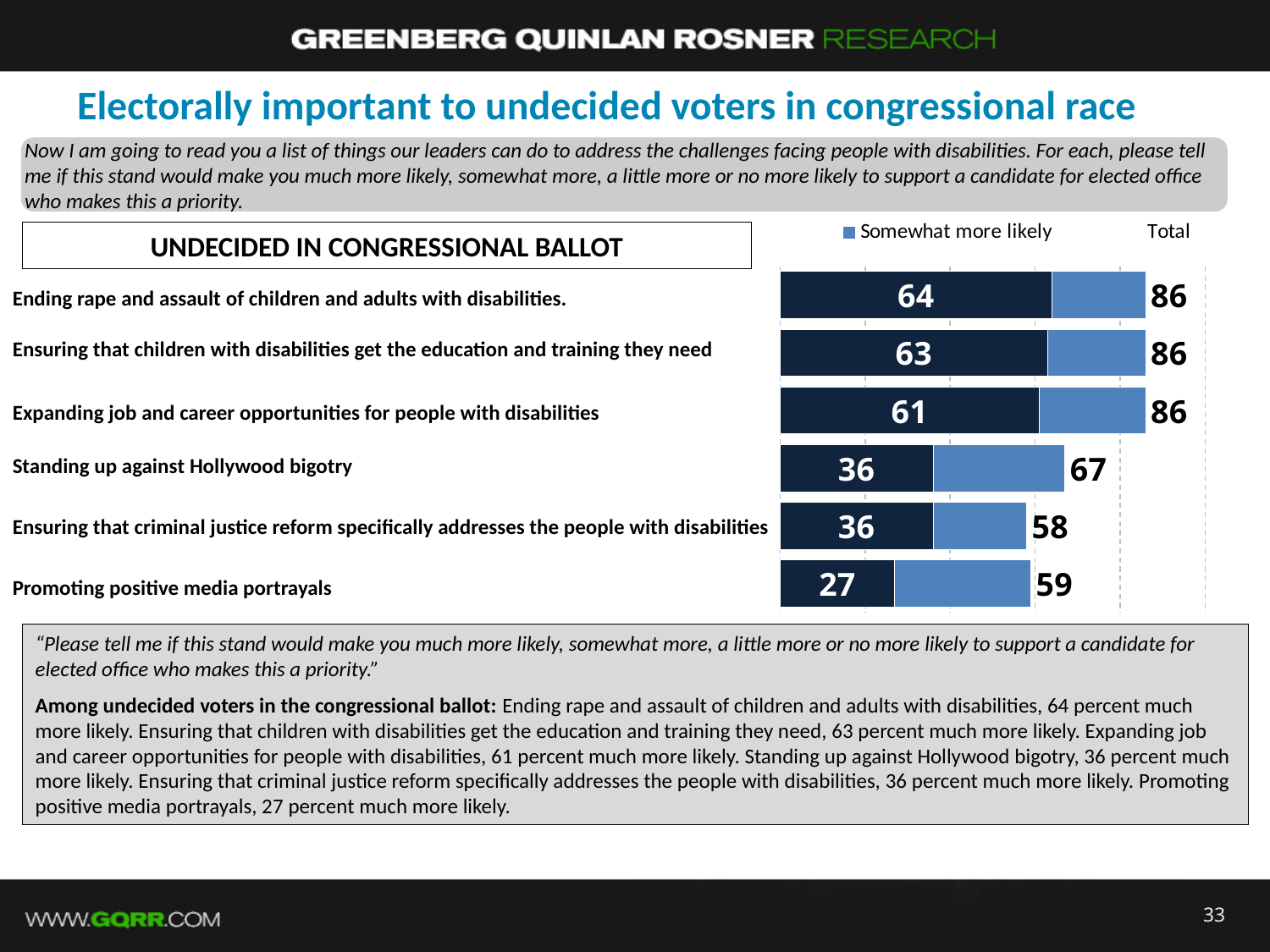
What is the value printed inside the dark bar segment for "Ending rape and assault of children and adults with disabilities"? 64 Which category has the highest value printed in its dark bar segment? Ending rape and assault of children and adults with disabilities What is the Total shown for "Standing up against Hollywood bigotry"? 67 Which category has the lowest value printed in its dark bar segment? Promoting positive media portrayals What is the difference between the dark-segment values for "Ending rape and assault of children and adults with disabilities" and "Promoting positive media portrayals"? 37 What is the value printed inside the dark bar segment for "Expanding job and career opportunities for people with disabilities"? 61 Based on the printed dark-segment value and Total, what is the "Somewhat more likely" value for "Standing up against Hollywood bigotry"? 31 Which has the larger Total: "Ensuring that criminal justice reform specifically addresses the people with disabilities" or "Promoting positive media portrayals"? Promoting positive media portrayals What type of chart is shown on the slide? Bar chart How many categories are plotted in the chart? 6 What is the Total shown for "Promoting positive media portrayals"? 59 Which category has the lowest Total? Ensuring that criminal justice reform specifically addresses the people with disabilities